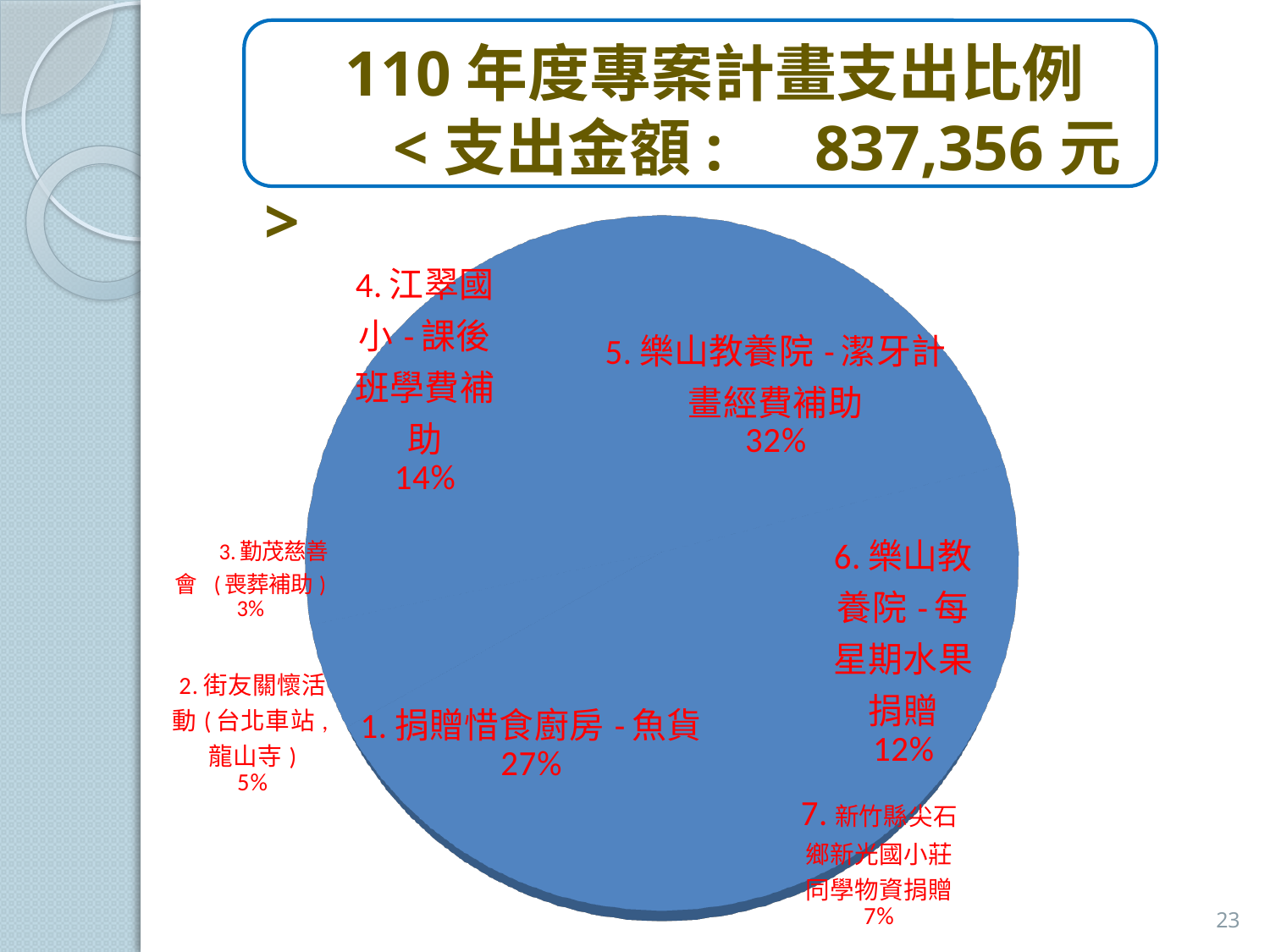
Which has a larger share: 6. 樂山教養院-每星期水果捐贈 or 2. 街友關懷活動(台北車站, 龍山寺)? 6. 樂山教養院-每星期水果捐贈 What share of spending does 5. 樂山教養院-潔牙計畫經費補助 account for? 32% What percentage is shown for 7. 新竹縣尖石鄉新光國小莊同學物資捐贈? 7% What total spending amount is stated in the chart title? 837,356 元 What percentage is shown for 1. 捐贈惜食廚房-魚貨? 27% How many categories are shown in the pie chart? 7 What is the combined share of 2. 街友關懷活動(台北車站, 龍山寺) and 3. 勤茂慈善會（喪葬補助）? 8% What percentage is shown for 4. 江翠國小-課後班學費補助? 14% Which category has the smallest share of the pie? 3. 勤茂慈善會（喪葬補助） Which category has the largest share of the pie? 5. 樂山教養院-潔牙計畫經費補助 What kind of chart is shown on the slide? Pie chart What is the difference in percentage points between 5. 樂山教養院-潔牙計畫經費補助 and 1. 捐贈惜食廚房-魚貨? 5